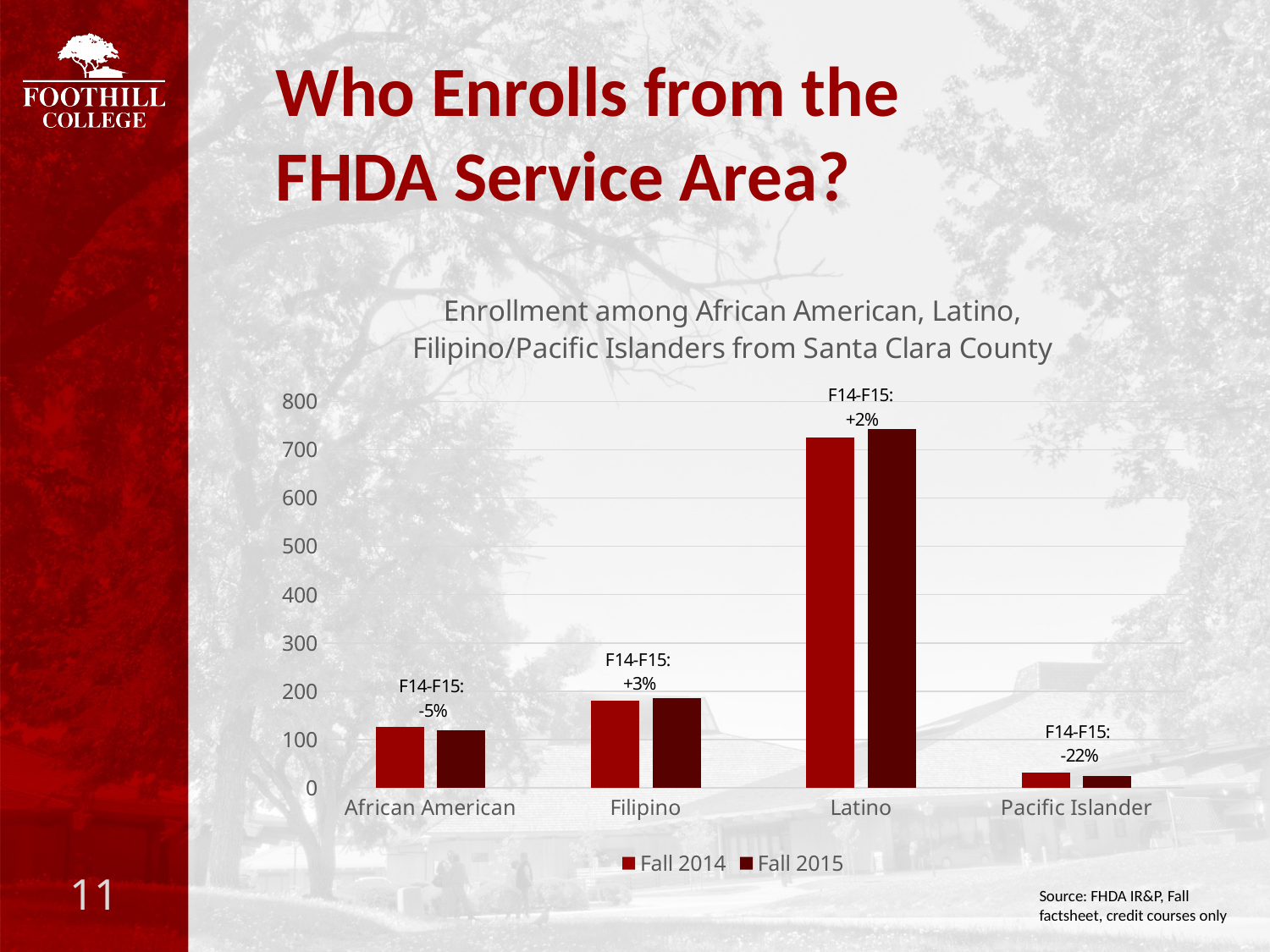
Which is larger: the Fall 2014 value for Filipino or the Fall 2014 value for African American? Filipino Is the Fall 2015 value for Pacific Islander greater or less than 100? less What is the F14-F15 change printed above the Latino bars? +2% Which category has the lowest enrollment in the chart? Pacific Islander What is the F14-F15 change printed above the Pacific Islander bars? -22% How many categories are shown on the x axis of the chart? 4 How many series does the chart's legend list? 2 What is the title of the chart? Enrollment among African American, Latino, Filipino/Pacific Islanders from Santa Clara County What is the F14-F15 change printed above the African American bars? -5% Which category has the highest enrollment in the chart? Latino Is the Fall 2014 value for Latino greater or less than 600? greater What kind of chart is shown on the slide? bar chart